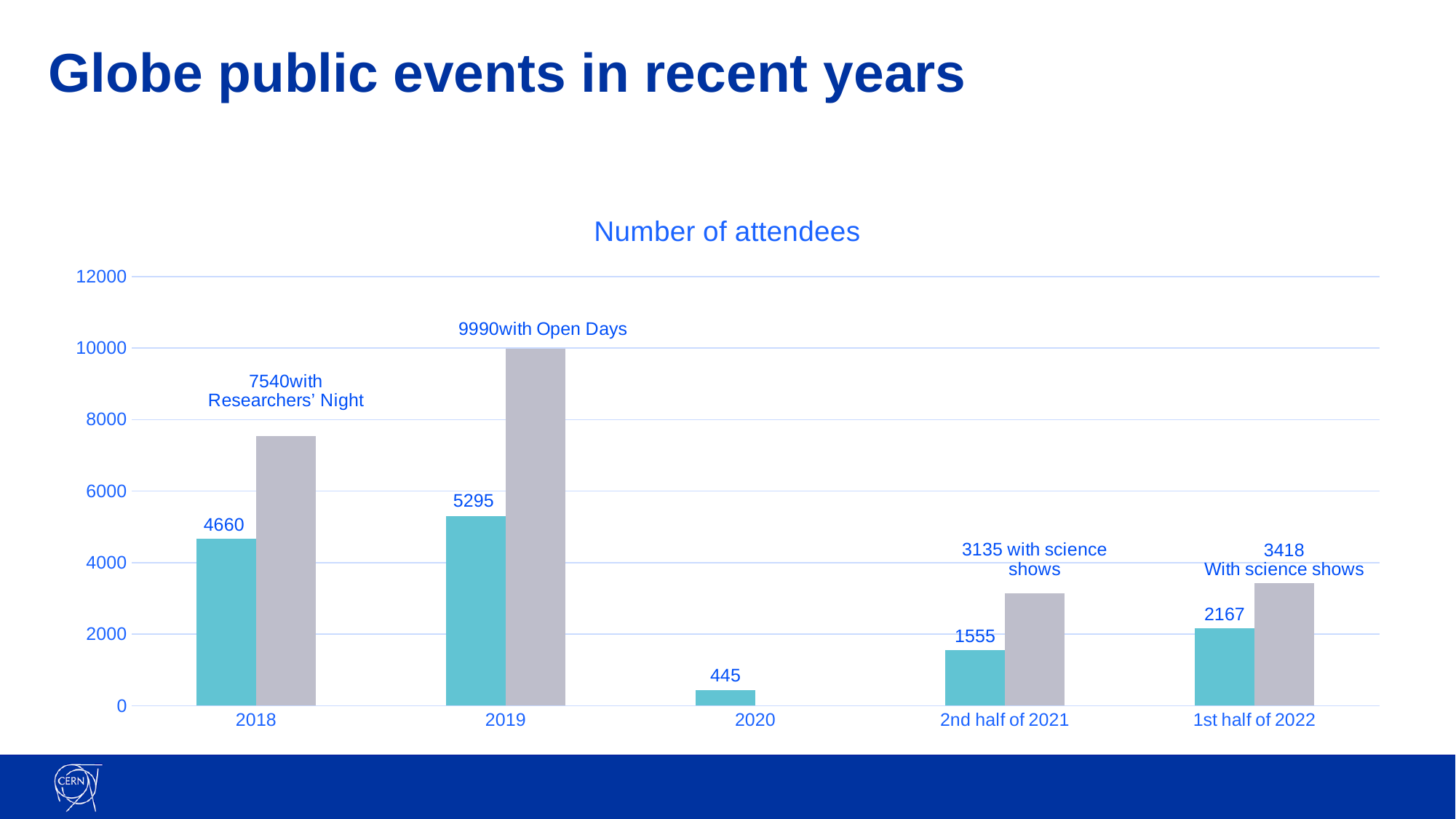
Which category has the tallest bar in the chart? 2019 What is the number of attendees shown for 2020? 445 What kind of chart is shown on the slide? bar chart What is the value of the grey bar for 2019, labelled 'with Open Days'? 9990 What is the title of the chart? Number of attendees What is the difference between the grey bar (7540) and the teal bar (4660) for 2018? 2880 Which category has the lowest number of attendees? 2020 How many categories are shown on the x axis of the chart? 5 Is the teal bar for 1st half of 2022 larger or smaller than the teal bar for 2nd half of 2021? larger What is the value of the teal bar for 2019? 5295 What is the value of the grey bar for 2nd half of 2021, labelled 'with science shows'? 3135 What is the value of the teal bar for 2018? 4660